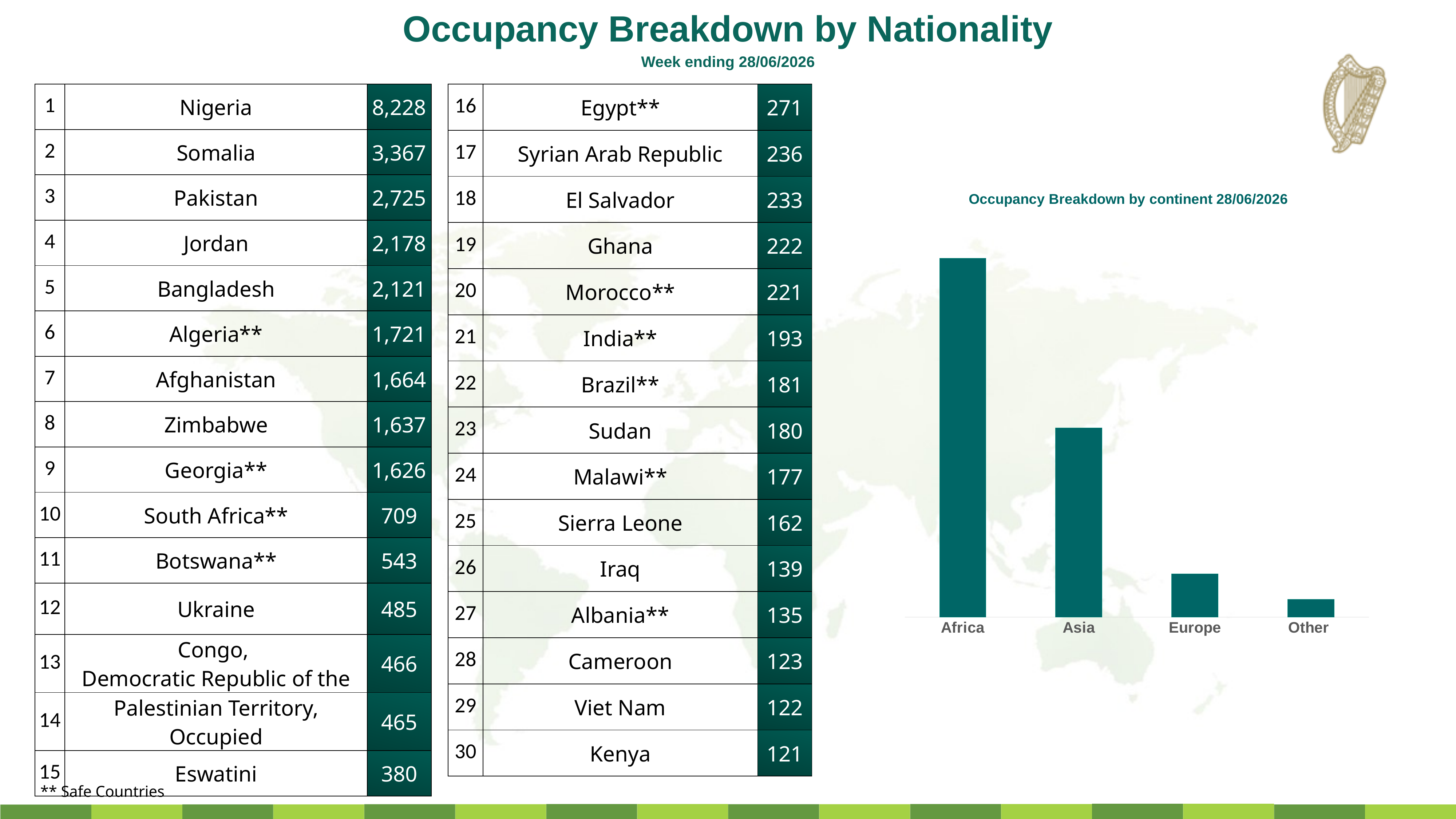
In the 'Occupancy Breakdown by continent 28/06/2026' chart, which category has the lowest value? Other What is the label of the first category on the x axis of the 'Occupancy Breakdown by continent 28/06/2026' chart? Africa In the 'Occupancy Breakdown by continent 28/06/2026' chart, which is larger, Europe or Other? Europe How many categories are shown on the x axis of the 'Occupancy Breakdown by continent 28/06/2026' chart? 4 In the 'Occupancy Breakdown by continent 28/06/2026' chart, which continent has the highest value? Africa In the 'Occupancy Breakdown by continent 28/06/2026' chart, which is larger, Asia or Europe? Asia What is the title of the bar chart on the right of the slide? Occupancy Breakdown by continent 28/06/2026 What type of chart is the 'Occupancy Breakdown by continent 28/06/2026' chart? bar chart In the 'Occupancy Breakdown by continent 28/06/2026' chart, do the values rise or fall from left to right along the x axis? fall In the 'Occupancy Breakdown by continent 28/06/2026' chart, which is larger, Africa or Asia? Africa